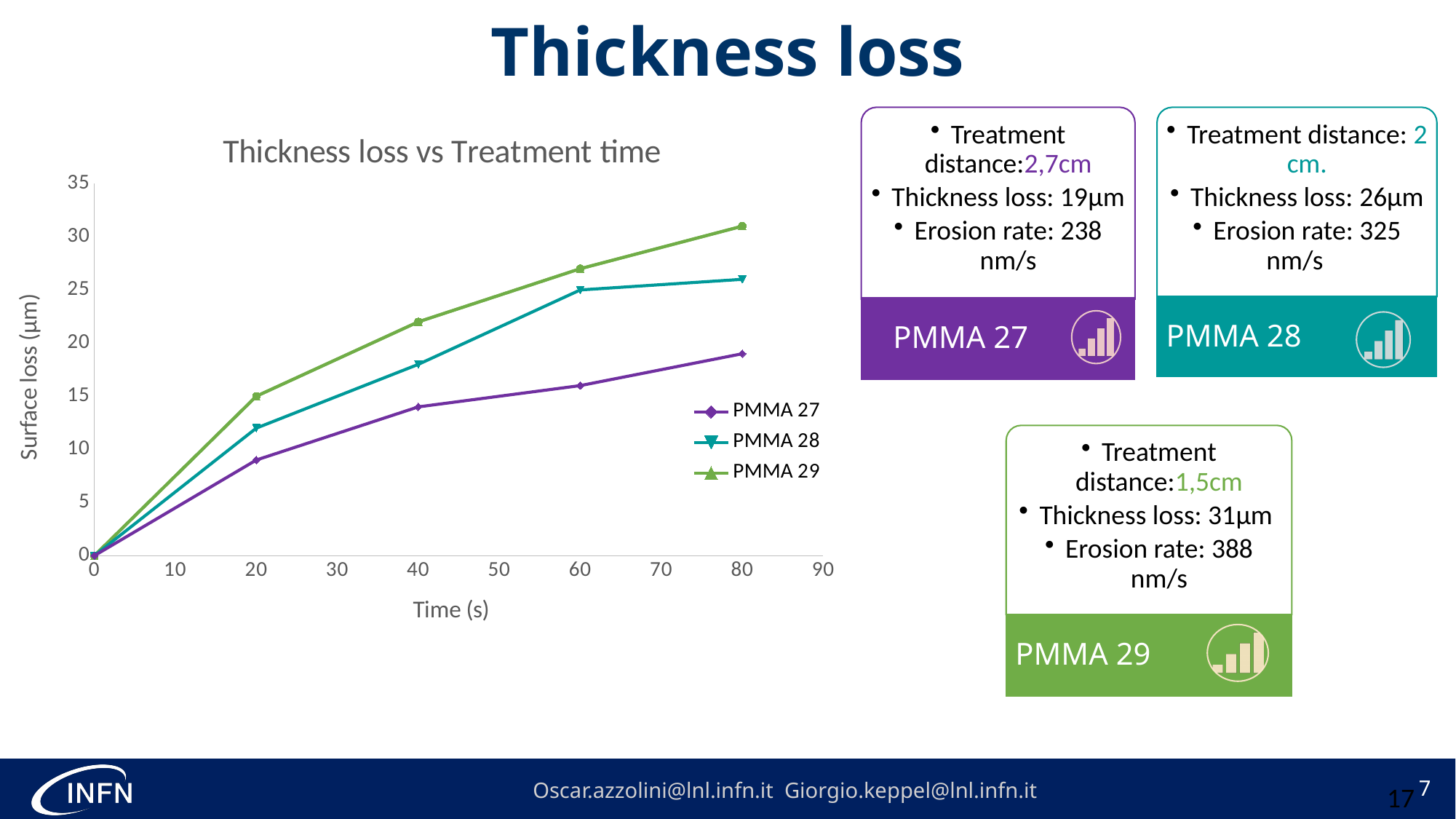
How many data points are plotted for the PMMA 29 series? 5 Is the surface loss for PMMA 29 at 60 s greater or less than 25? greater How many series does the chart legend list? 3 Which series has the highest surface loss at 80 s? PMMA 29 What is the title of the chart? Thickness loss vs Treatment time Does the surface loss for PMMA 28 rise or fall as time increases? rise At 40 s, which series has the larger surface loss, PMMA 27 or PMMA 28? PMMA 28 What is the label of the vertical axis of the chart? Surface loss (µm) Is the surface loss for PMMA 27 at 20 s greater or less than 10? less What kind of chart is shown on the slide? line chart Is the surface loss for PMMA 27 at 80 s greater or less than 20? less Which series has the lowest surface loss at 80 s? PMMA 27